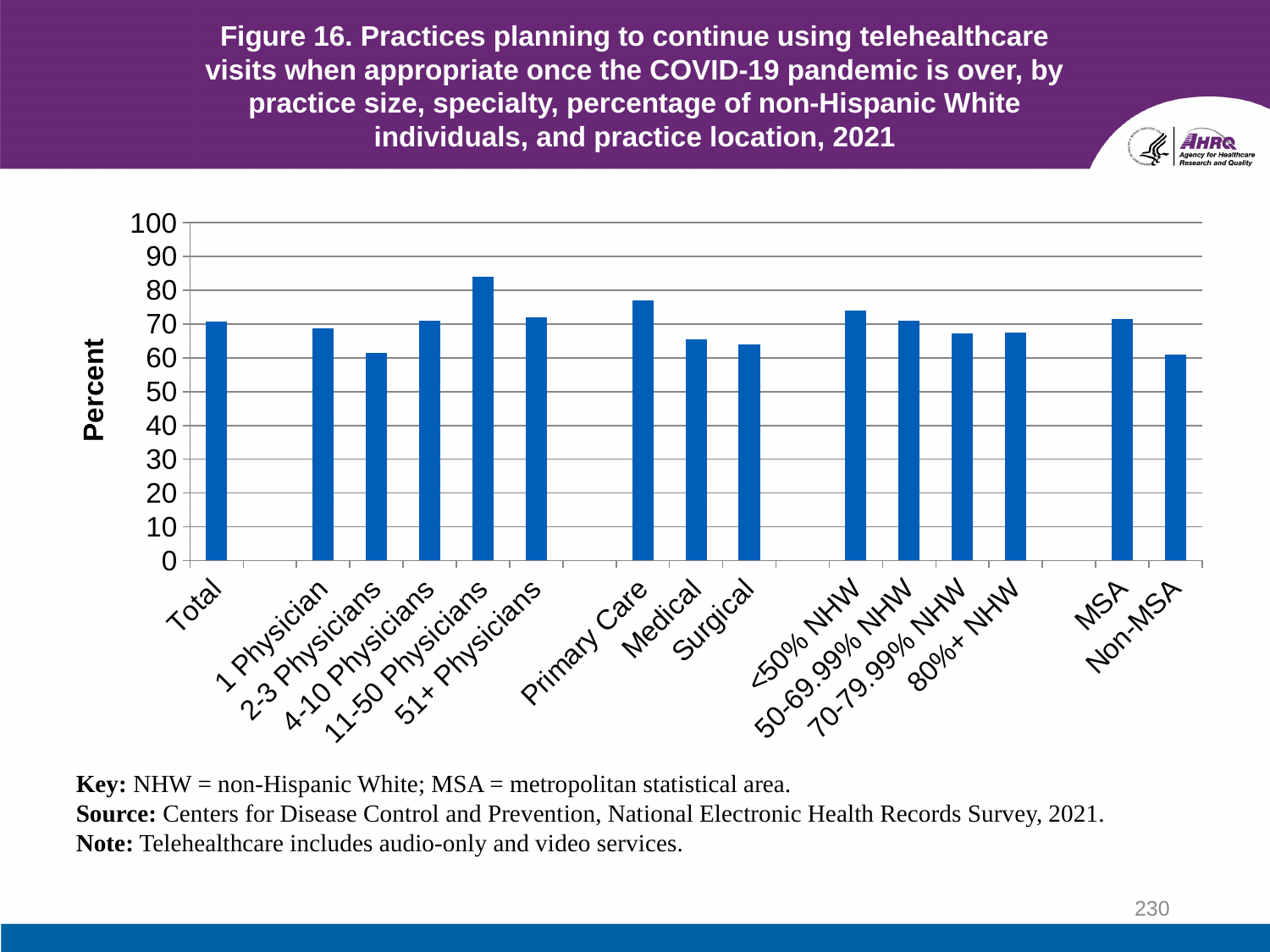
Is the value for 2-3 Physicians greater or less than 70? less Which is larger, the value for Primary Care or the value for Surgical? Primary Care What is the label on the vertical axis of the chart? Percent Which is larger, the value for <50% NHW or the value for 70-79.99% NHW? <50% NHW Is the value for 11-50 Physicians greater or less than 80? greater Which category has the highest value in the chart? 11-50 Physicians Which is larger, the value for MSA or the value for Non-MSA? MSA Is the value for Medical greater or less than 70? less How many bars (categories) are plotted in the chart? 15 What kind of chart is shown on the slide? bar chart